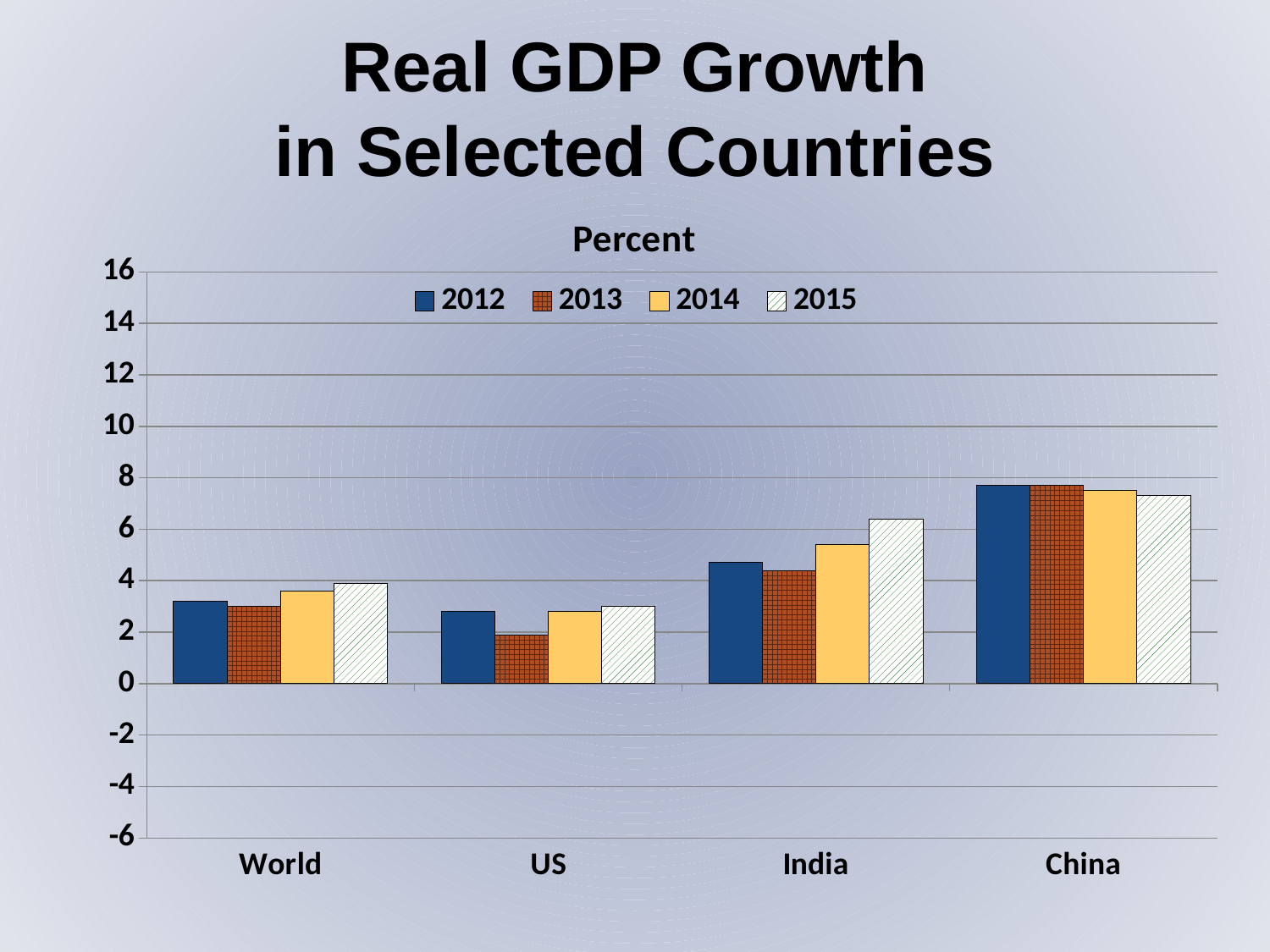
Which year is represented by the solid dark blue bars in the legend? 2012 How many countries or regions are shown on the x axis? 4 Which category has the highest real GDP growth in 2012? China What kind of chart is shown on the slide? bar chart Which category has the lowest real GDP growth in 2013? US Is the 2015 value for India greater or less than 6? greater Do the values for India rise or fall from 2013 to 2015? rise Is the 2014 value for China greater or less than 8? less How many series does the legend list? 4 Which is larger, the 2015 value for India or the 2015 value for the US? India What is the title of the chart's axis label shown above the plot area? Percent